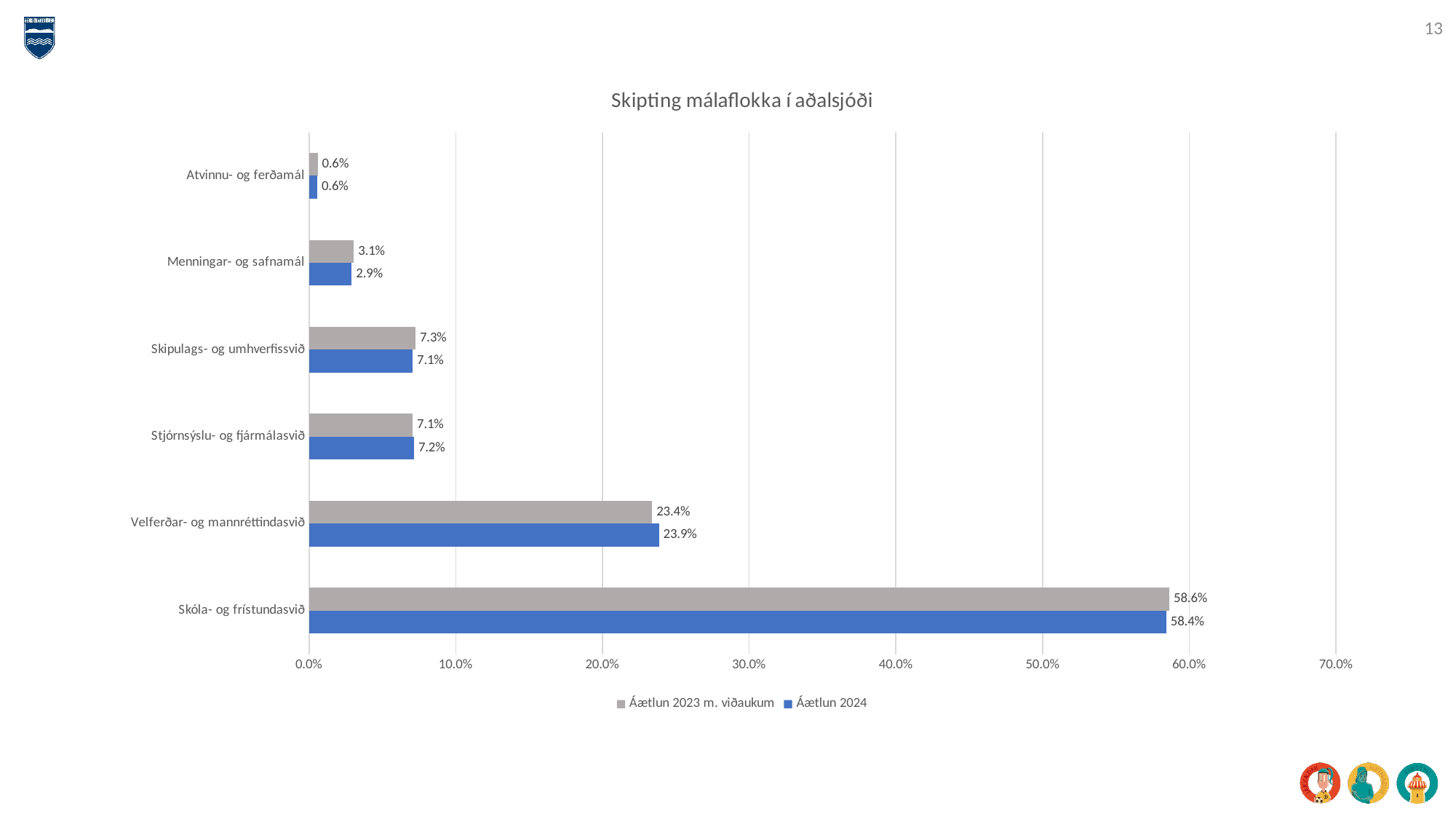
Which category has the lowest value in the Áætlun 2023 m. viðaukum series? Atvinnu- og ferðamál What kind of chart is shown on the slide? Bar chart What is the title of the chart? Skipting málaflokka í aðalsjóði What is the value for Velferðar- og mannréttindasvið in the Áætlun 2023 m. viðaukum series? 23.4% How many categories are shown on the chart? 6 What is the value for Skóla- og frístundasvið in the Áætlun 2024 series? 58.4% What is the value for Menningar- og safnamál in the Áætlun 2024 series? 2.9% Which category has the highest value in the Áætlun 2024 series? Skóla- og frístundasvið Which is larger for Skipulags- og umhverfissvið: the Áætlun 2023 m. viðaukum value or the Áætlun 2024 value? Áætlun 2023 m. viðaukum Is the Áætlun 2024 value for Skóla- og frístundasvið greater or less than 50.0%? greater What is the difference between the Áætlun 2023 m. viðaukum and Áætlun 2024 values for Velferðar- og mannréttindasvið? 0.5% How many series does the legend list? 2